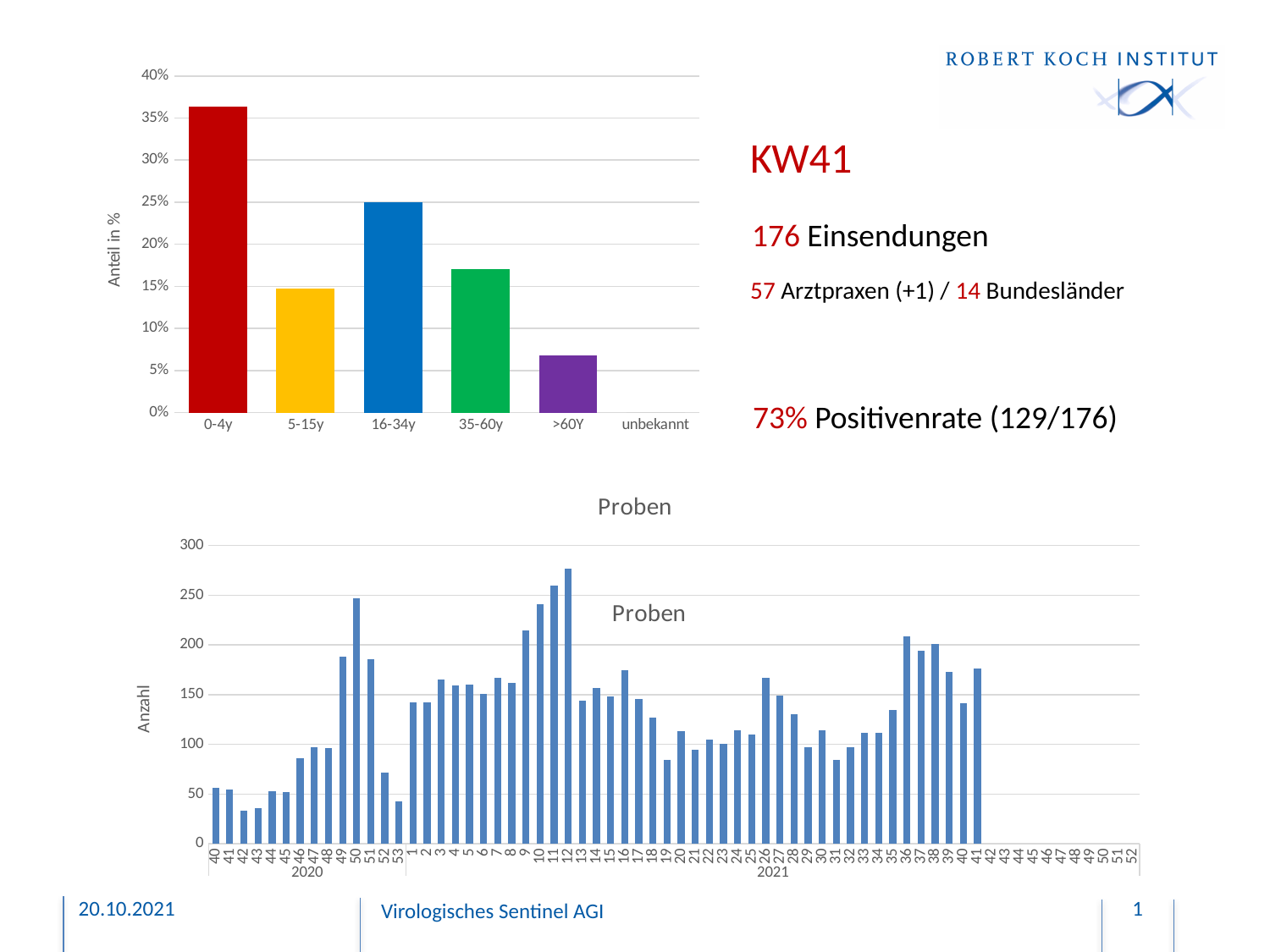
What kind of chart is the top-left chart showing 'Anteil in %' by age group? bar chart What is the title of the bottom chart? Proben In the top-left age-group chart, which is larger, the share for 16-34y or the share for 35-60y? 16-34y In the top-left age-group chart, is the value for >60Y greater or less than 10%? less In the top-left age-group chart, which labelled age group has the lowest visible bar? >60Y In the top-left age-group chart, which age group has the highest share? 0-4y In the bottom 'Proben' chart, which week of 2021 has the highest number of samples? 12 In the top-left age-group chart, is the value for 0-4y greater or less than 35%? greater How many age-group categories are shown on the x axis of the top-left chart? 6 In the bottom 'Proben' chart, is the value for week 19 of 2021 greater or less than 100? less What is the y-axis label of the top-left age-group chart? Anteil in %